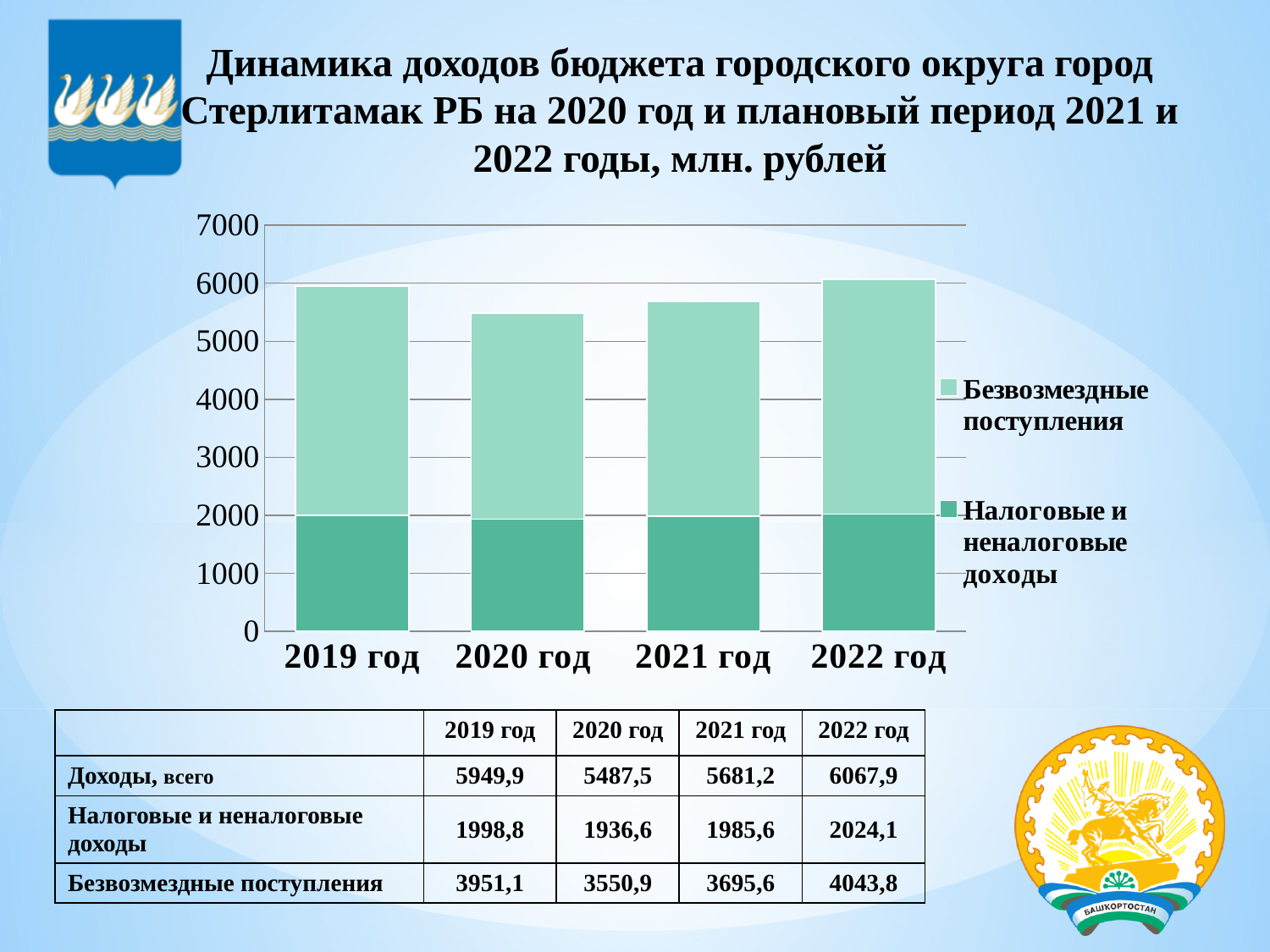
What is the value of Налоговые и неналоговые доходы for 2020 год? 1936,6 What is the value of Безвозмездные поступления for 2022 год? 4043,8 What is the difference between Безвозмездные поступления in 2022 год and 2020 год? 492,9 Which is larger: Безвозмездные поступления in 2019 год or in 2021 год? 2019 год Is the total stacked bar for 2021 год greater or less than 6000? less How many years (categories) are shown on the x axis of the chart? 4 What kind of chart is shown on the slide? stacked bar chart How many series does the chart legend list? 2 What is the total height of the stacked bar for 2019 год (Доходы, всего)? 5949,9 Which year has the highest total income (tallest stacked bar)? 2022 год Which legend entry is shown in the darker green colour? Налоговые и неналоговые доходы Which year has the lowest total income (shortest stacked bar)? 2020 год